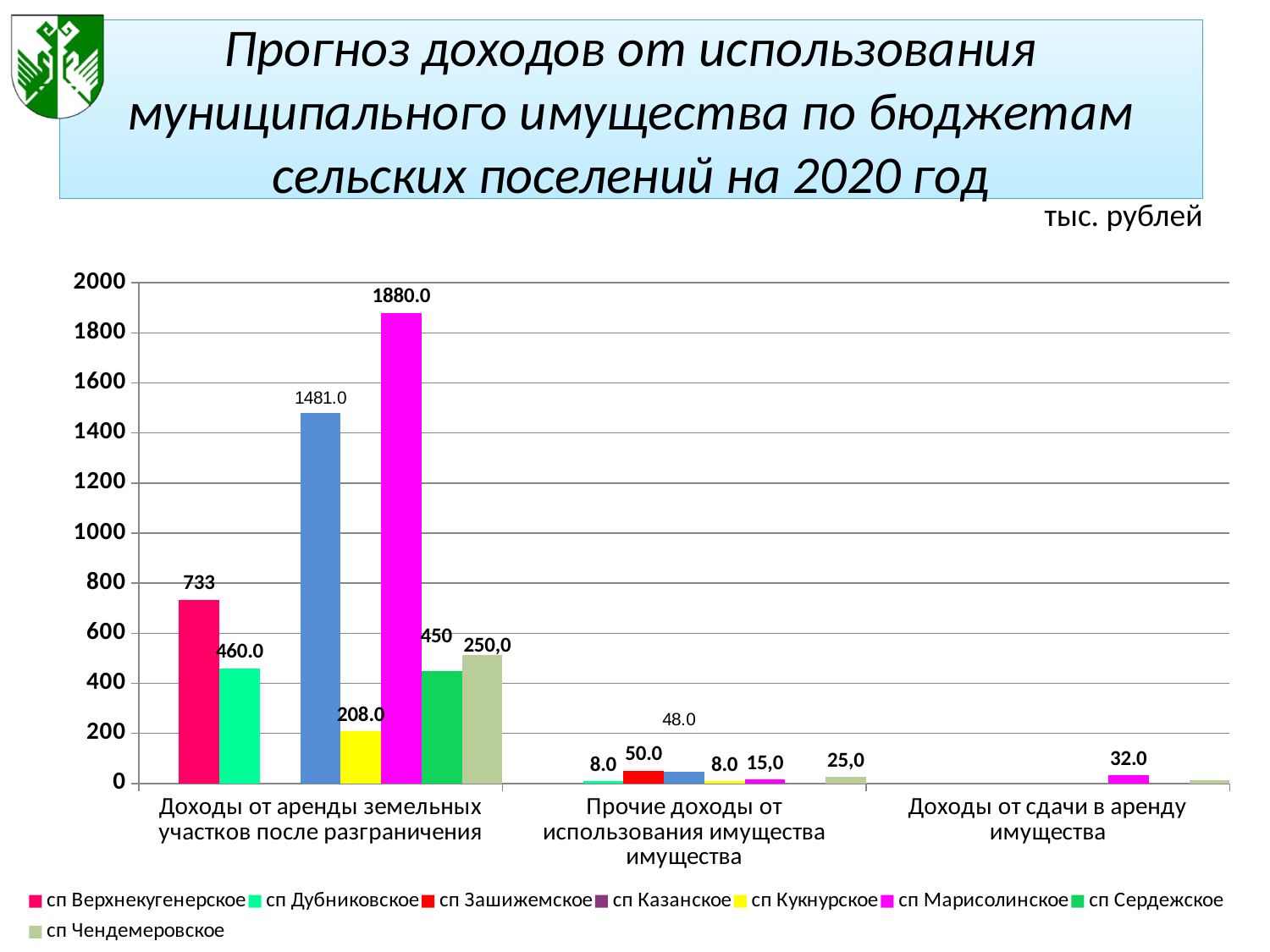
What is the value for сп Марисолинское in the category "Доходы от сдачи в аренду имущества"? 32.0 How many categories are shown on the x axis? 3 What is the value for сп Марисолинское in the category "Доходы от аренды земельных участков после разграничения"? 1880.0 Which series has the highest value in the category "Доходы от аренды земельных участков после разграничения"? сп Марисолинское What is the value for сп Зашижемское in the category "Прочие доходы от использования имущества"? 50.0 How many series does the legend list? 8 In the category "Доходы от аренды земельных участков после разграничения", which is larger: сп Верхнекугенерское or сп Дубниковское? сп Верхнекугенерское What kind of chart is shown on the slide? bar chart What is the value for сп Верхнекугенерское in the category "Доходы от аренды земельных участков после разграничения"? 733 What is the value for сп Кукнурское in the category "Доходы от аренды земельных участков после разграничения"? 208.0 What is the difference between сп Верхнекугенерское (733) and сп Дубниковское (460.0) in the category "Доходы от аренды земельных участков после разграничения"? 273 What unit of measurement is stated on the slide for the chart values? тыс. рублей